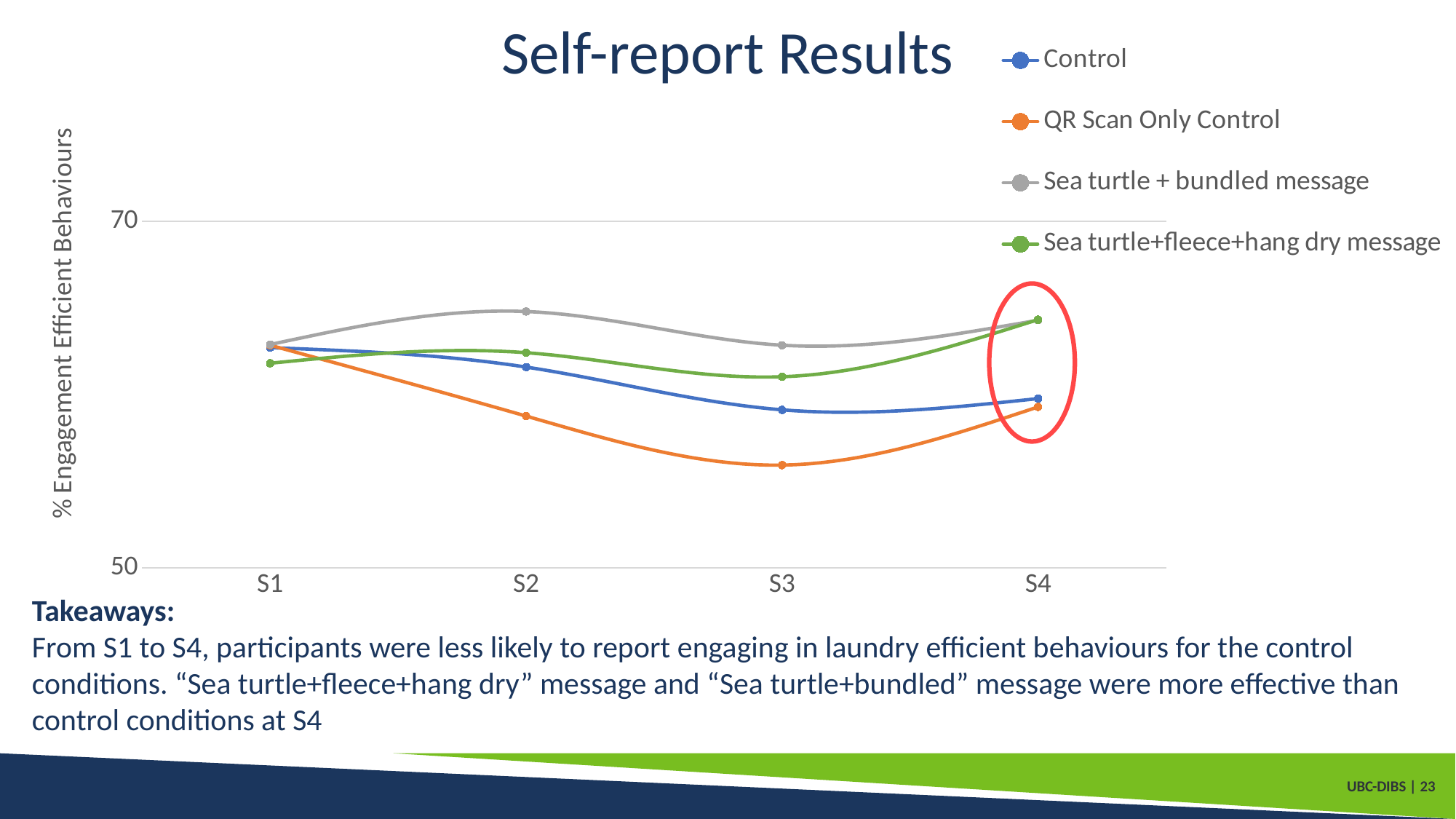
At S4, which is larger: the value for Sea turtle+fleece+hang dry message or the value for QR Scan Only Control? Sea turtle+fleece+hang dry message Which series has the lowest value at S2? QR Scan Only Control Does the value for Sea turtle+fleece+hang dry message rise or fall from S3 to S4? rise At S3, which is larger: the value for Sea turtle + bundled message or the value for QR Scan Only Control? Sea turtle + bundled message Is the value for Sea turtle + bundled message at S2 greater or less than 70? less What kind of chart is shown on the slide? line chart Which series has the lowest value at S3? QR Scan Only Control How many time points are shown on the x axis? 4 How many series does the legend list? 4 What is the label on the y axis of the chart? % Engagement Efficient Behaviours Does the value for QR Scan Only Control rise or fall from S1 to S3? fall Which series has the highest value at S2? Sea turtle + bundled message